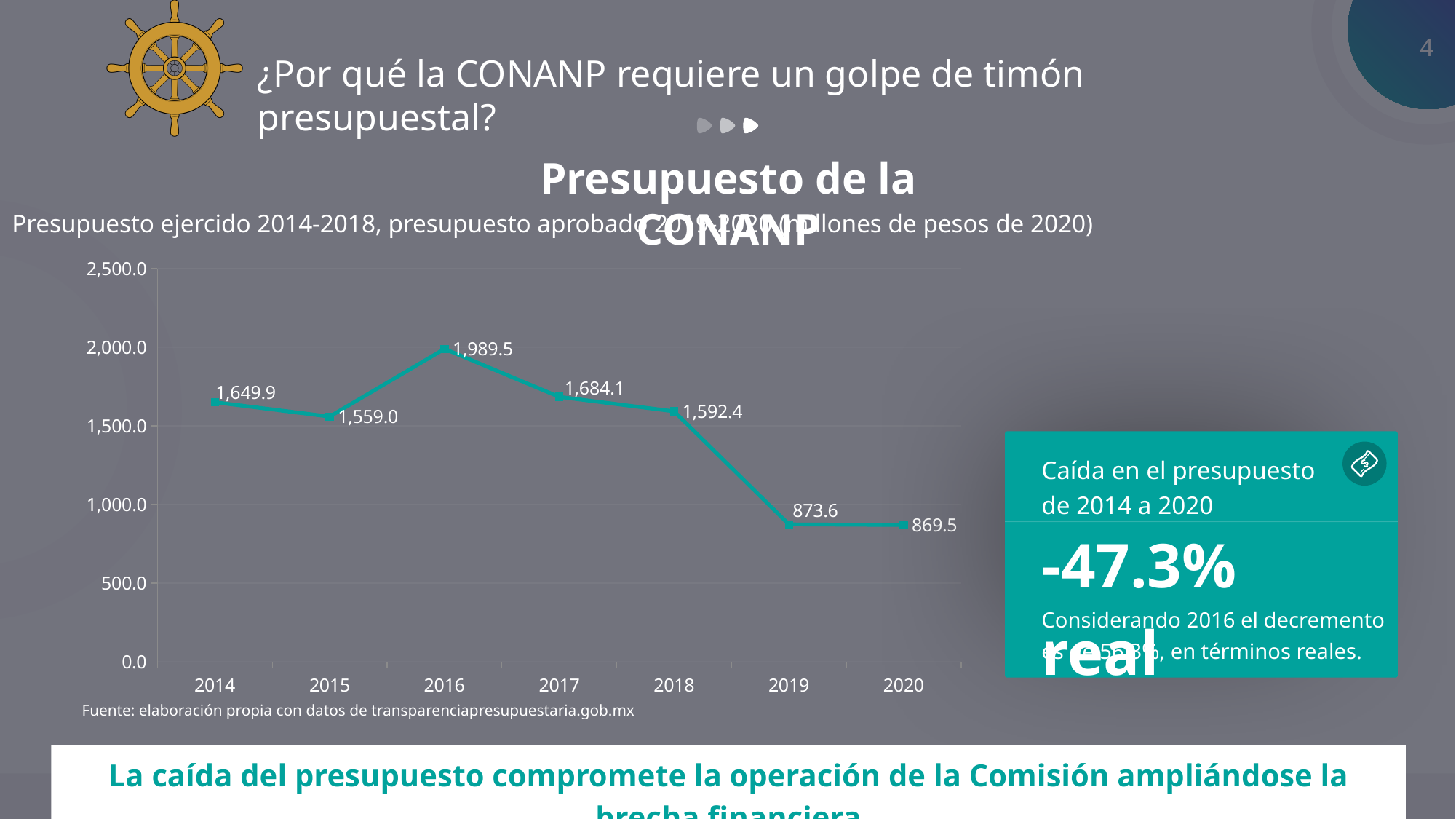
Is the value for 2019 greater or less than 1,000.0? less What is the value for 2016? 1,989.5 What is the difference between the values for 2016 and 2017? 305.4 How many years are plotted on the chart? 7 What kind of chart is shown? line chart What is the difference between the values for 2018 and 2019? 718.8 Which year has the lowest value? 2020 Which year has the highest value? 2016 What is the value for 2014? 1,649.9 Do the values rise or fall from 2018 to 2020? fall What is the value for 2019? 873.6 Which is larger, the value for 2015 or the value for 2017? 2017